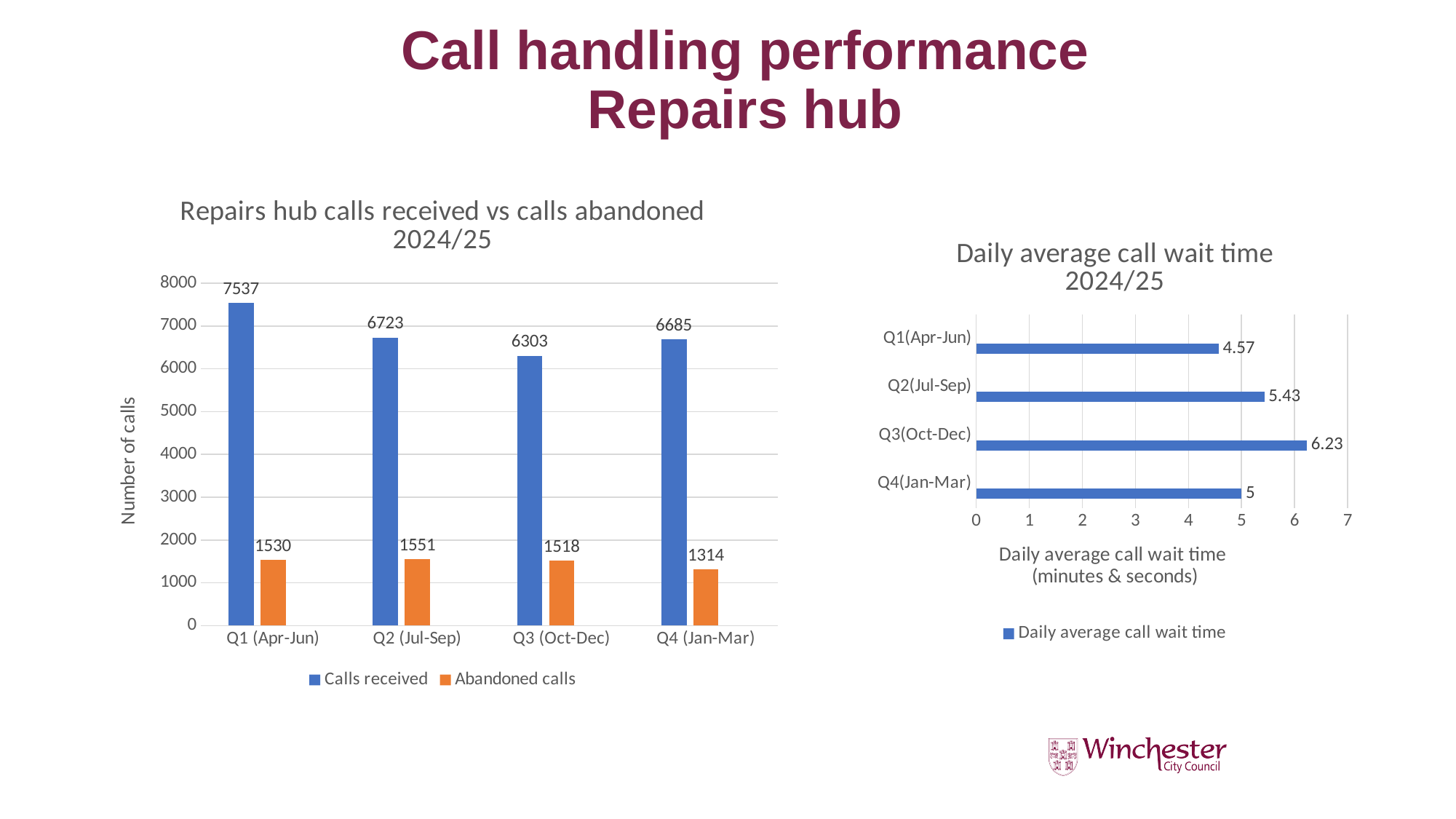
What type of chart is the 'Daily average call wait time 2024/25' chart? Bar chart How many quarters are shown in the 'Daily average call wait time 2024/25' chart? 4 In the 'Daily average call wait time 2024/25' chart, what is the value for Q3(Oct-Dec)? 6.23 In the 'Repairs hub calls received vs calls abandoned 2024/25' chart, how many calls were abandoned in Q4 (Jan-Mar)? 1314 How many series does the legend of the 'Repairs hub calls received vs calls abandoned 2024/25' chart list? 2 In the 'Repairs hub calls received vs calls abandoned 2024/25' chart, were more calls received in Q2 (Jul-Sep) or Q4 (Jan-Mar)? Q2 (Jul-Sep) In the 'Repairs hub calls received vs calls abandoned 2024/25' chart, how many calls were received in Q1 (Apr-Jun)? 7537 In the 'Daily average call wait time 2024/25' chart, which quarter has the lowest daily average call wait time? Q1(Apr-Jun) What is the y-axis label of the 'Repairs hub calls received vs calls abandoned 2024/25' chart? Number of calls In the 'Repairs hub calls received vs calls abandoned 2024/25' chart, what is the difference between calls received and abandoned calls in Q3 (Oct-Dec)? 4785 In the 'Repairs hub calls received vs calls abandoned 2024/25' chart, which quarter had the highest number of calls received? Q1 (Apr-Jun) In the 'Repairs hub calls received vs calls abandoned 2024/25' chart, which quarter had the lowest number of abandoned calls? Q4 (Jan-Mar)